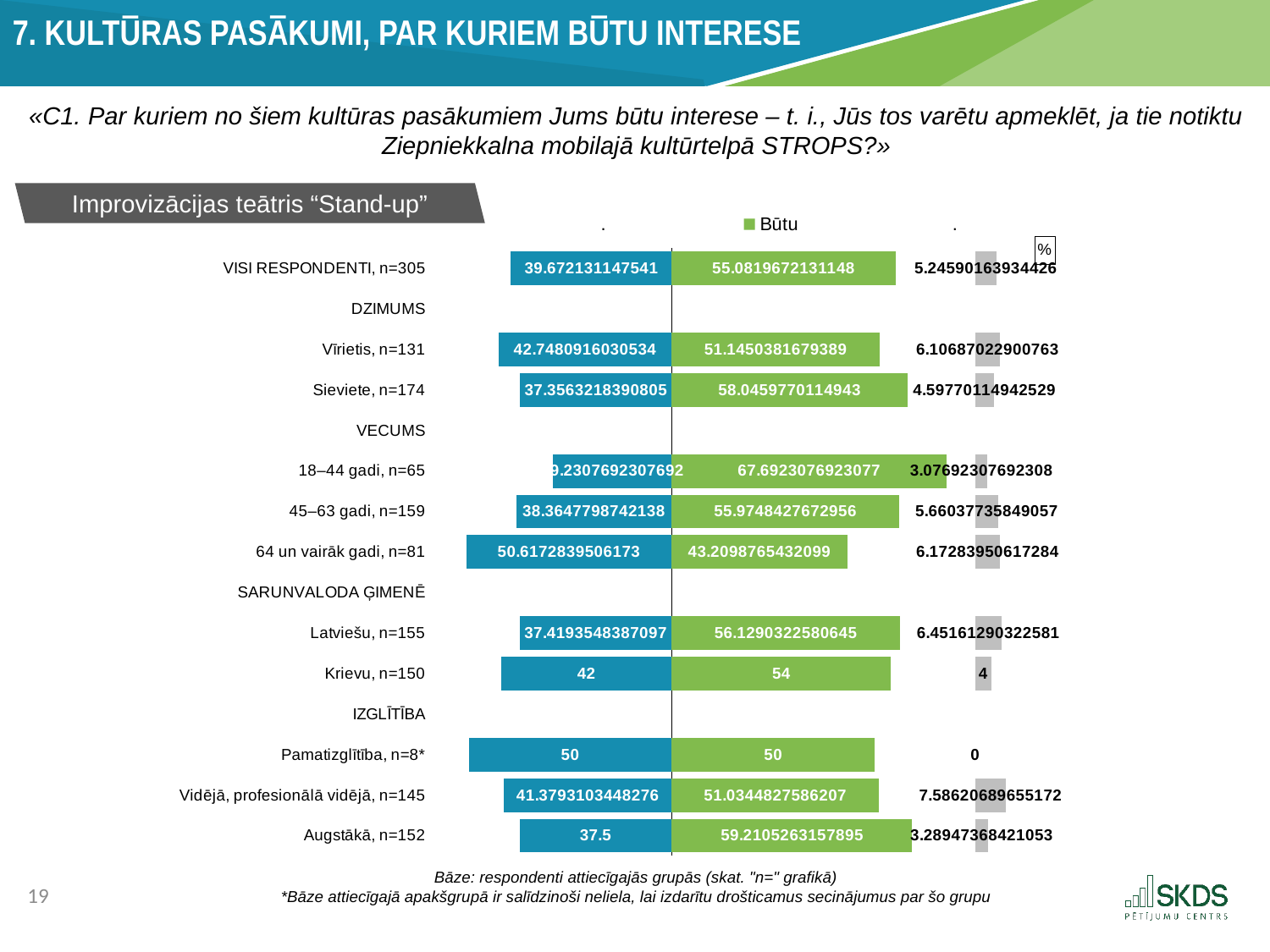
Which respondent group has the highest "Būtu" value? 18–44 gadi, n=65 What is the "Būtu" value for VISI RESPONDENTI, n=305? 55.0819672131148 How many series does the legend list? 3 What is the value of the blue (left) segment for Augstākā, n=152? 37.5 Which has the larger "Būtu" value, Vīrietis, n=131 or Sieviete, n=174? Sieviete, n=174 How many respondent groups have bars plotted in the chart? 11 Which respondent group has the lowest "Būtu" value? 64 un vairāk gadi, n=81 What is the "Būtu" value for Krievu, n=150? 54 What kind of chart is shown on the slide? Stacked bar chart What is the total of the three segments in the bar for Krievu, n=150? 100 What is the "Būtu" value for Augstākā, n=152? 59.2105263157895 For Krievu, n=150, what is the difference between the "Būtu" value and the blue (left) segment value? 12